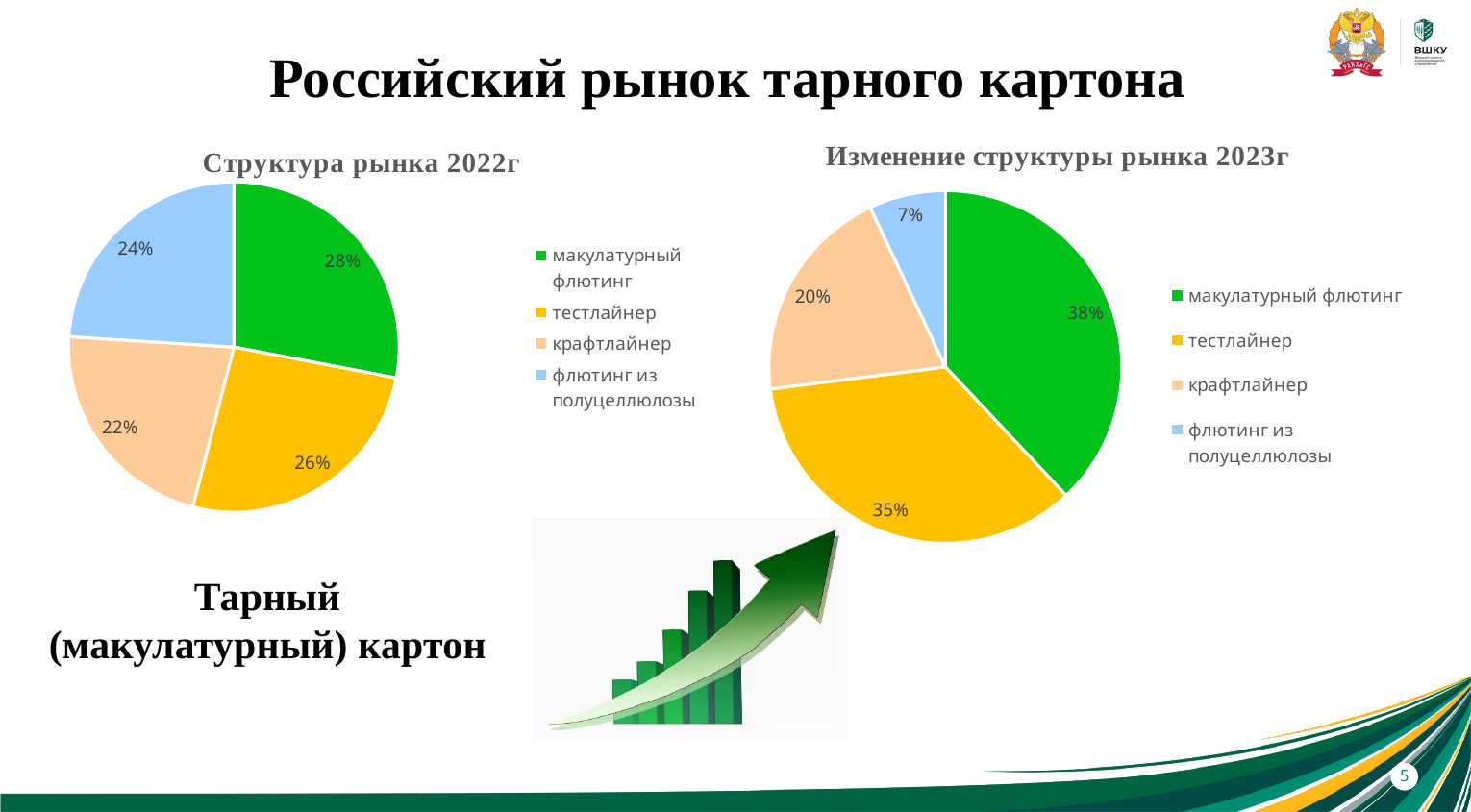
What type of chart is the chart titled "Изменение структуры рынка 2023г"? pie chart In the chart titled "Изменение структуры рынка 2023г", what is the share for тестлайнер? 35% How many slices does the chart titled "Структура рынка 2022г" have? 4 In the chart titled "Структура рынка 2022г", what is the difference between the shares of макулатурный флютинг and крафтлайнер? 6% In the chart titled "Структура рынка 2022г", what is the share for макулатурный флютинг? 28% In the chart titled "Изменение структуры рынка 2023г", which category has the smallest share? флютинг из полуцеллюлозы In the chart titled "Структура рынка 2022г", which colour represents тестлайнер? yellow In the chart titled "Изменение структуры рынка 2023г", which category has the largest share? макулатурный флютинг In the chart titled "Структура рынка 2022г", which category has the smallest share? крафтлайнер In the chart titled "Структура рынка 2022г", what is the share for флютинг из полуцеллюлозы? 24% In the chart titled "Изменение структуры рынка 2023г", what is the share for флютинг из полуцеллюлозы? 7% In the chart titled "Изменение структуры рынка 2023г", which is larger: the share of крафтлайнер or the share of флютинг из полуцеллюлозы? крафтлайнер